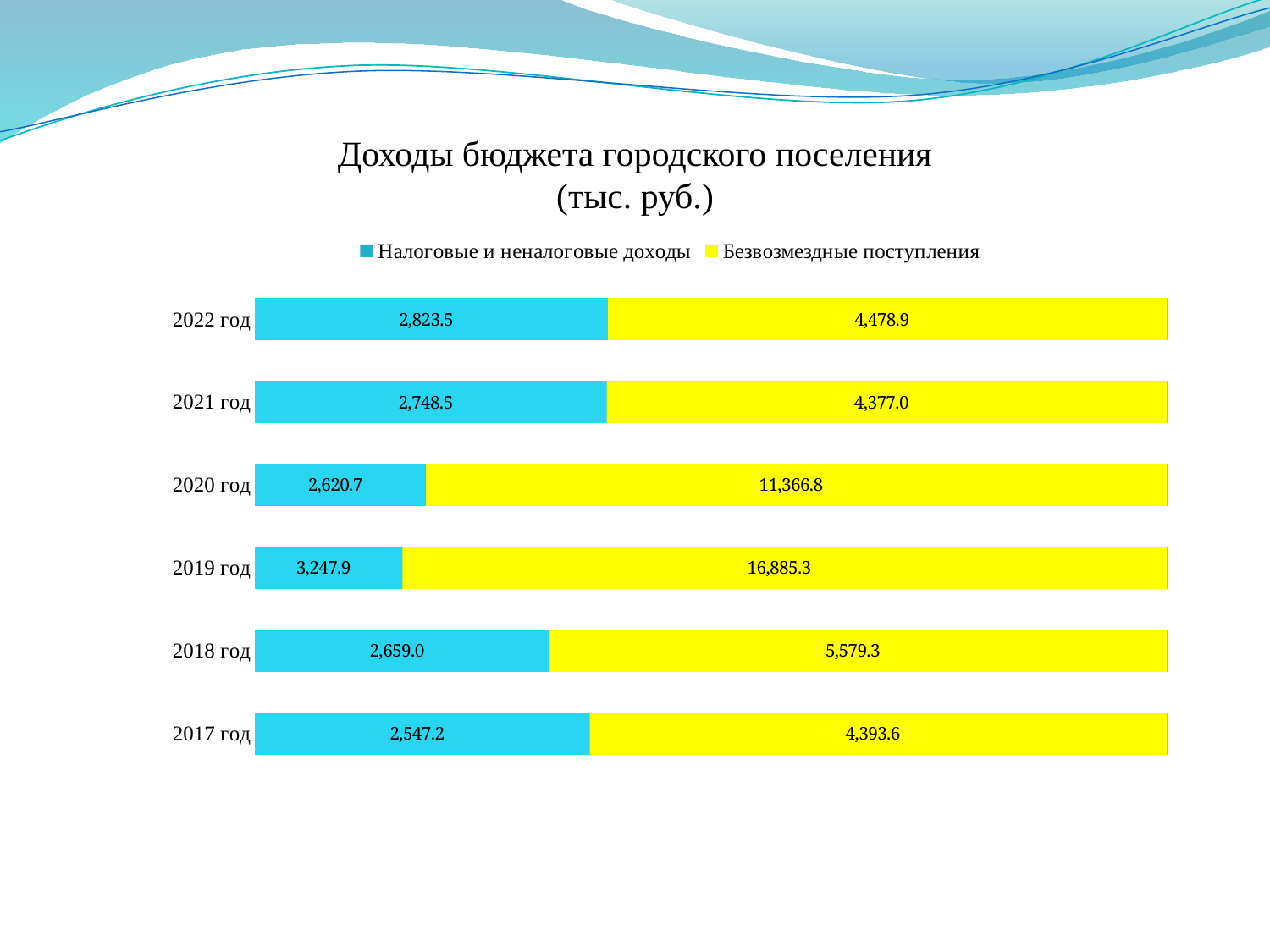
Which year has the highest value of Налоговые и неналоговые доходы? 2019 год How many series does the legend list? 2 What kind of chart is shown on the slide? Stacked bar chart What is the difference between Безвозмездные поступления and Налоговые и неналоговые доходы for 2022 год? 1,655.4 What is the value of Налоговые и неналоговые доходы for 2022 год? 2,823.5 What is the total of the stacked bar for 2019 год? 20,133.2 What is the value of Безвозмездные поступления for 2020 год? 11,366.8 How many years are shown on the chart? 6 Which is larger for 2018 год: Налоговые и неналоговые доходы or Безвозмездные поступления? Безвозмездные поступления Which year has the lowest value of Налоговые и неналоговые доходы? 2017 год Which year has the highest value of Безвозмездные поступления? 2019 год What is the value of Безвозмездные поступления for 2017 год? 4,393.6